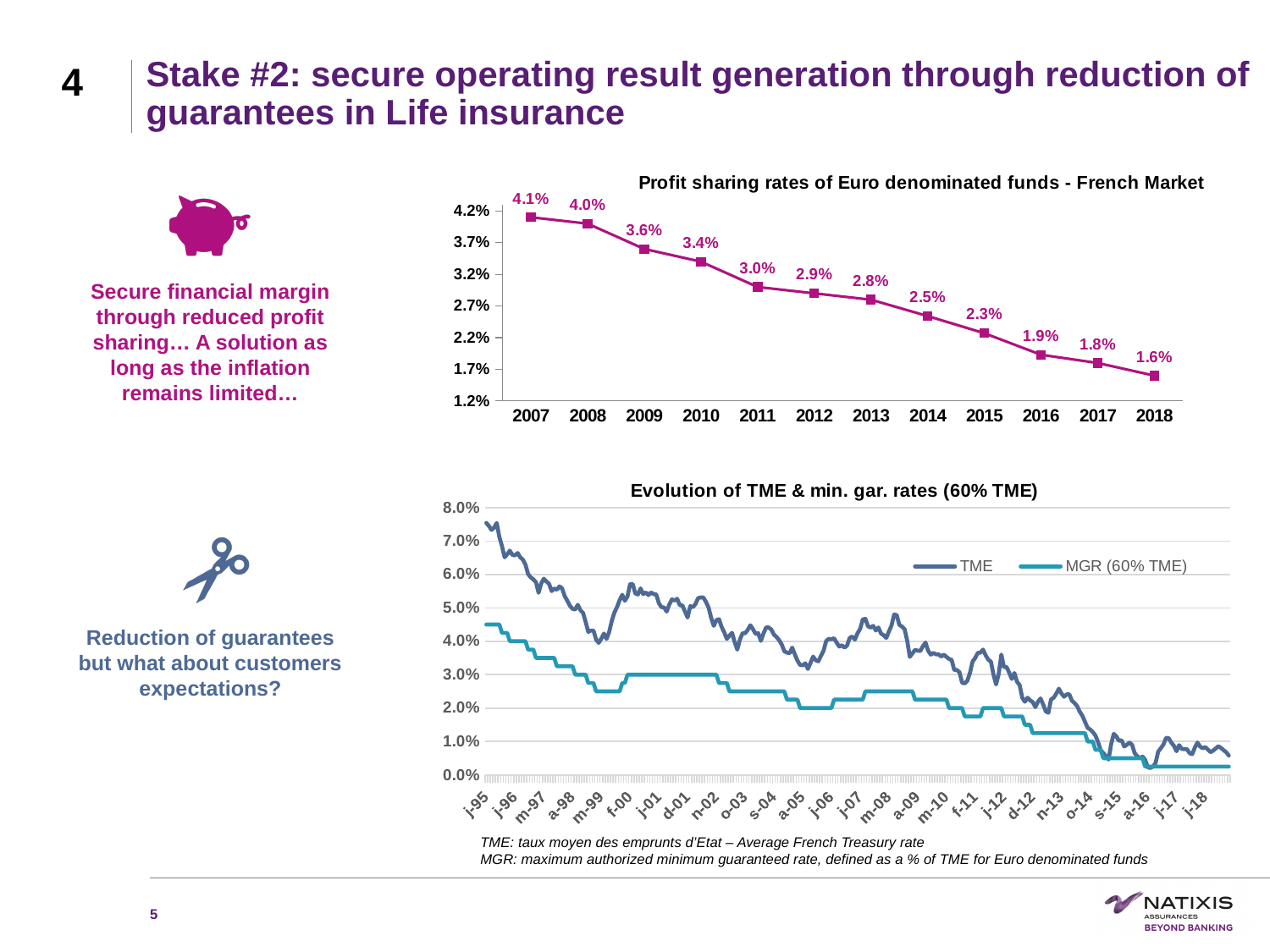
In the 'Evolution of TME & min. gar. rates (60% TME)' chart, how many series does the legend list? 2 In the 'Profit sharing rates of Euro denominated funds - French Market' chart, what is the value for 2007? 4.1% In the 'Profit sharing rates of Euro denominated funds - French Market' chart, which year has the lowest value? 2018 In the 'Evolution of TME & min. gar. rates (60% TME)' chart, what are the two series named in the legend? TME and MGR (60% TME) In the 'Profit sharing rates of Euro denominated funds - French Market' chart, how many years are plotted? 12 In the 'Profit sharing rates of Euro denominated funds - French Market' chart, what is the value for 2014? 2.5% In the 'Profit sharing rates of Euro denominated funds - French Market' chart, do the values rise or fall from 2007 to 2018? fall In the 'Profit sharing rates of Euro denominated funds - French Market' chart, what is the value for 2018? 1.6% In the 'Profit sharing rates of Euro denominated funds - French Market' chart, what is the difference between the 2007 and 2018 values? 2.5% What kind of chart is the 'Profit sharing rates of Euro denominated funds - French Market' chart? line chart In the 'Profit sharing rates of Euro denominated funds - French Market' chart, which year has the highest value? 2007 In the 'Evolution of TME & min. gar. rates (60% TME)' chart, is the TME value at j-95 greater or less than 7.0%? greater